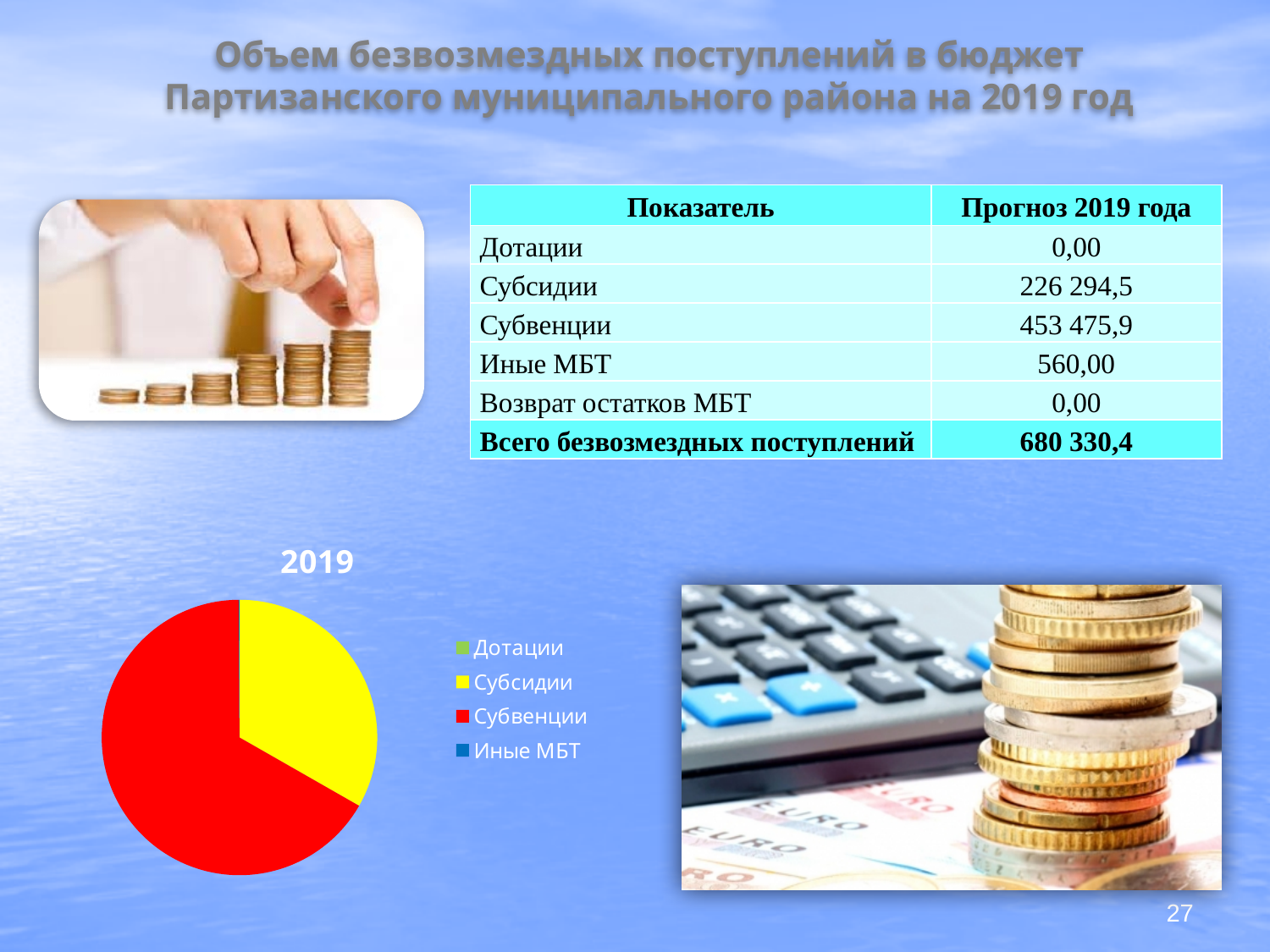
How many entries does the pie chart's legend list? 4 Which category has the largest slice in the pie chart? Субвенции What is the value for Субвенции in the 2019 forecast? 453 475,9 What is the difference between the values for Субвенции and Субсидии? 227 181,4 What is the total of all безвозмездные поступления for 2019? 680 330,4 Which is larger in the pie chart, Субсидии or Субвенции? Субвенции What kind of chart is shown on the slide? pie chart What is the title of the pie chart? 2019 What is the value for Субсидии in the 2019 forecast? 226 294,5 What colour is the Субвенции slice in the pie chart? red Which legend category has the smallest value, Дотации or Субсидии? Дотации What is the value for Иные МБТ in the 2019 forecast? 560,00